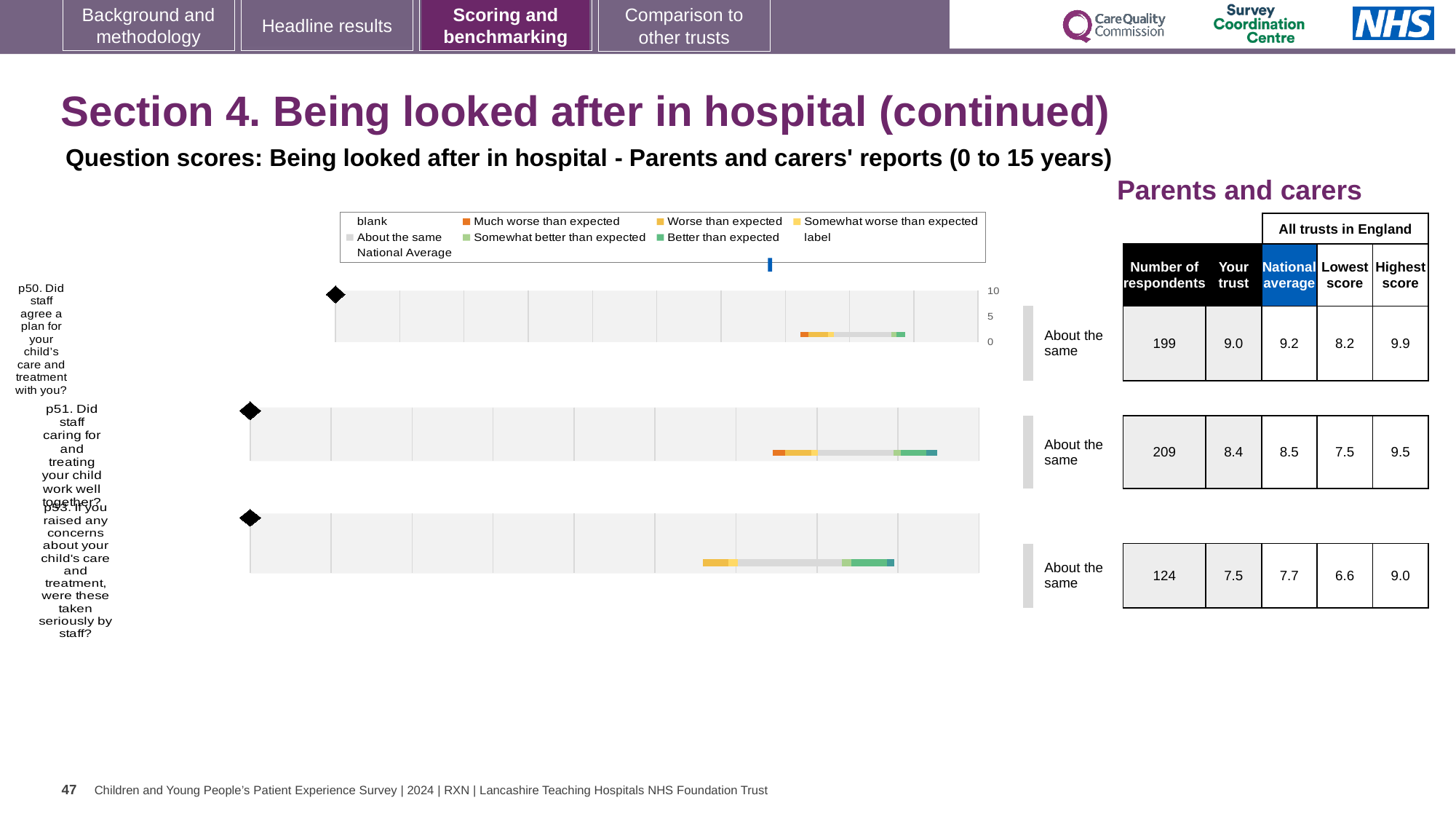
What is the difference between the national average and the 'Your trust' score for p50? 0.2 What is the difference between the highest score and the lowest score for p53? 2.4 What benchmark label is shown next to the p53 chart? About the same What kind of chart is used to show the benchmark results for each question on this slide? bar chart Which question has the lowest number of respondents? p53 What is the highest value shown on the vertical axis of the p50 chart? 10 What is the 'Your trust' score for p50 (Did staff agree a plan for your child's care and treatment with you)? 9.0 Which question has the highest 'Your trust' score? p50 What is the highest score among all trusts in England for p53? 9.0 How many question charts are shown on the slide? 3 For p51, which is larger: the 'Your trust' score or the national average? National average What is the national average score for p51 (Did staff caring for and treating your child work well together)? 8.5